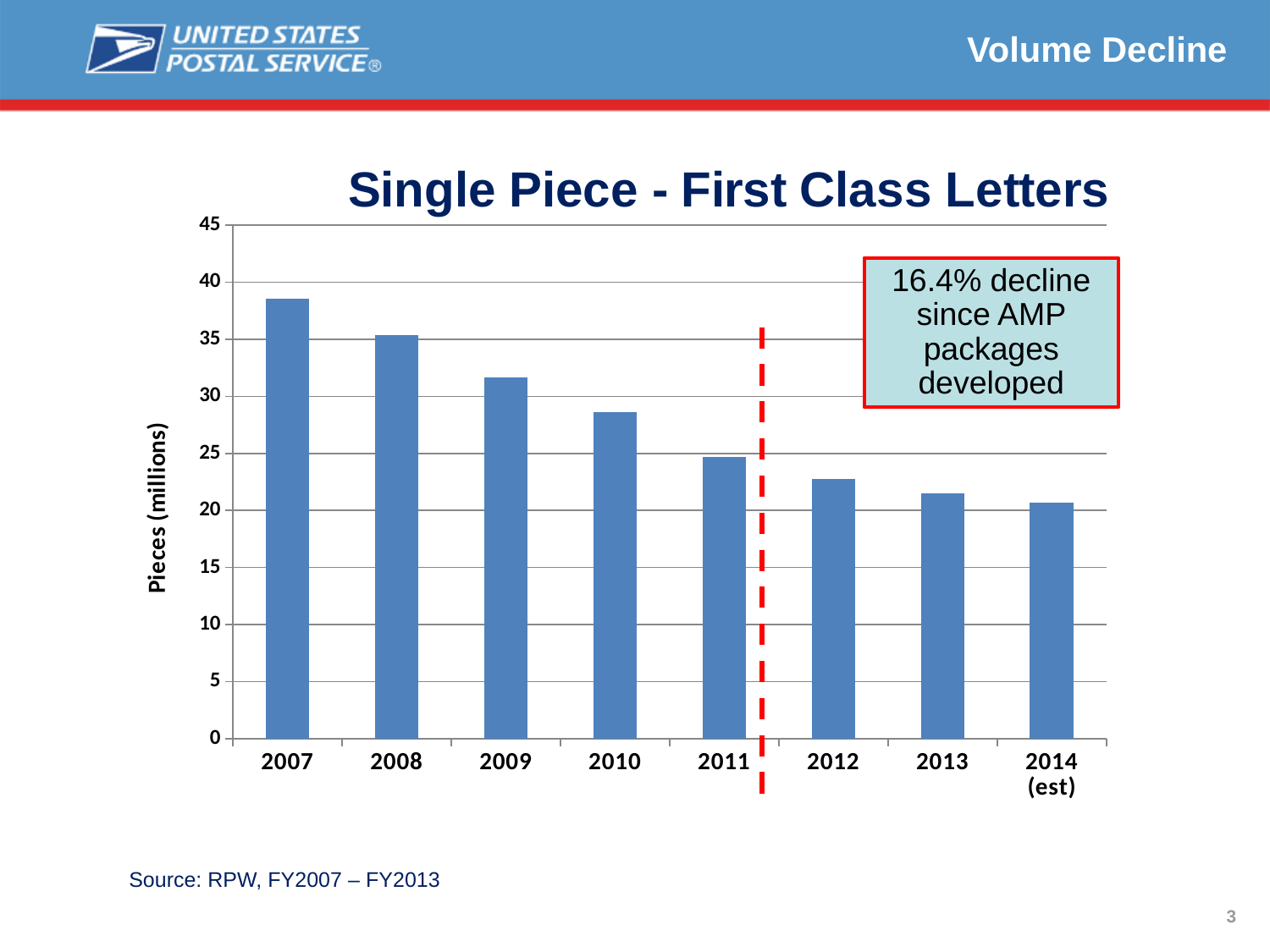
Which year has the lowest value in the chart? 2014 (est) What is the label on the vertical axis of the chart? Pieces (millions) Is the value for 2010 greater or less than 30? less What is the title of the chart? Single Piece - First Class Letters How many years are shown on the x axis of the chart? 8 Is the value for 2009 greater or less than 30? greater Which is larger, the value for 2009 or the value for 2011? 2009 Do the values rise or fall from 2007 to 2014 (est)? fall Is the value for 2007 greater or less than 35? greater Which year has the highest value in the chart? 2007 What type of chart is shown on the slide? bar chart